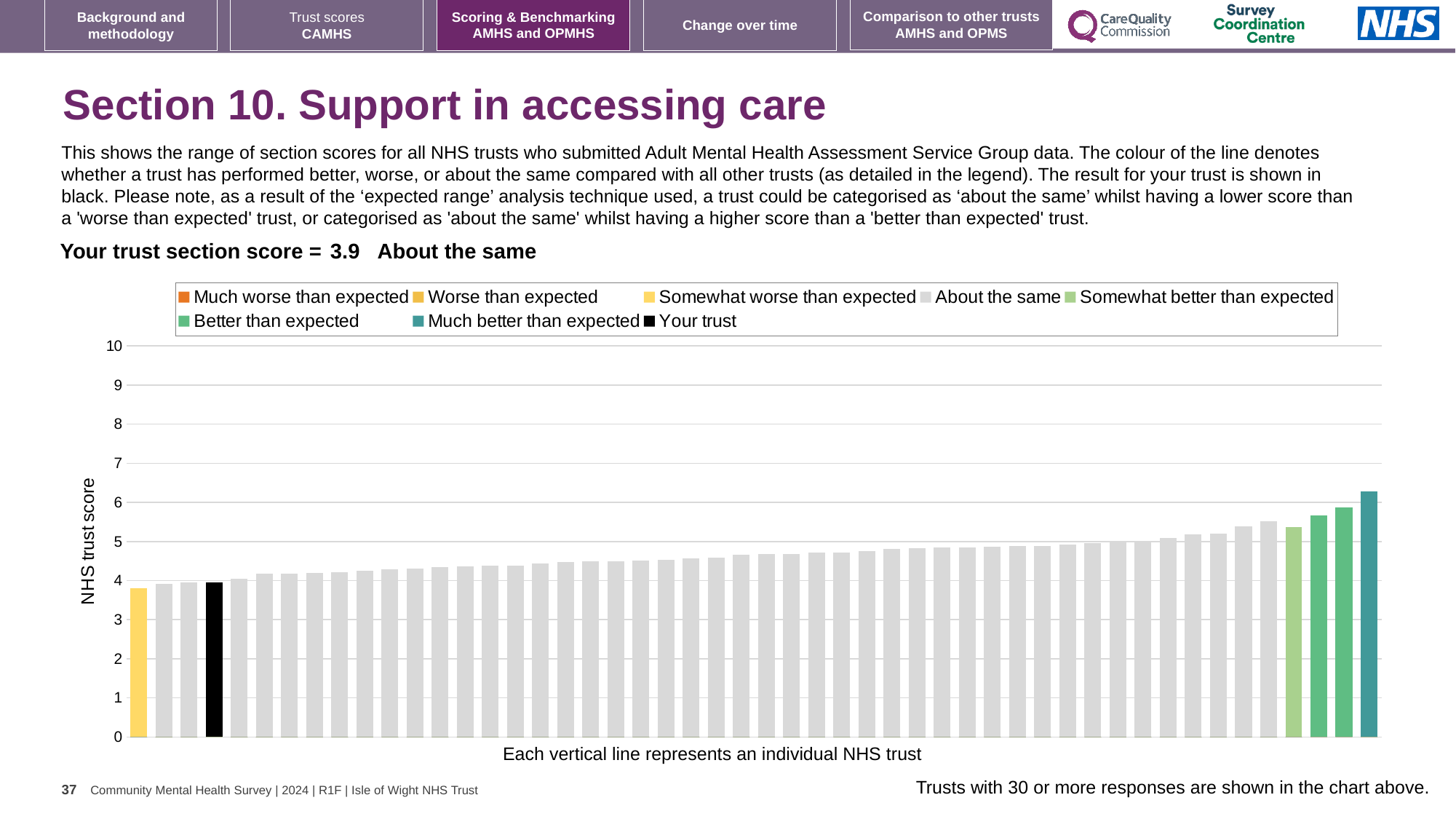
Is the value of the tallest bar greater or less than 6? greater How many entries does the chart legend list? 8 Which is larger, the teal 'Much better than expected' bar or the black 'Your trust' bar? Much better than expected Which legend category does the shortest bar in the chart belong to? Somewhat worse than expected What is the label on the y axis of the chart? NHS trust score Do the bar values rise or fall from left to right along the x axis? rise What kind of chart is shown on the slide? bar chart Which legend category does the tallest bar in the chart belong to? Much better than expected What is the section score for your trust shown on the slide? 3.9 Is the value of the black 'Your trust' bar greater or less than 5? less Is the value of the shortest bar greater or less than 5? less How many bars are coloured as 'Better than expected' (green)? 2